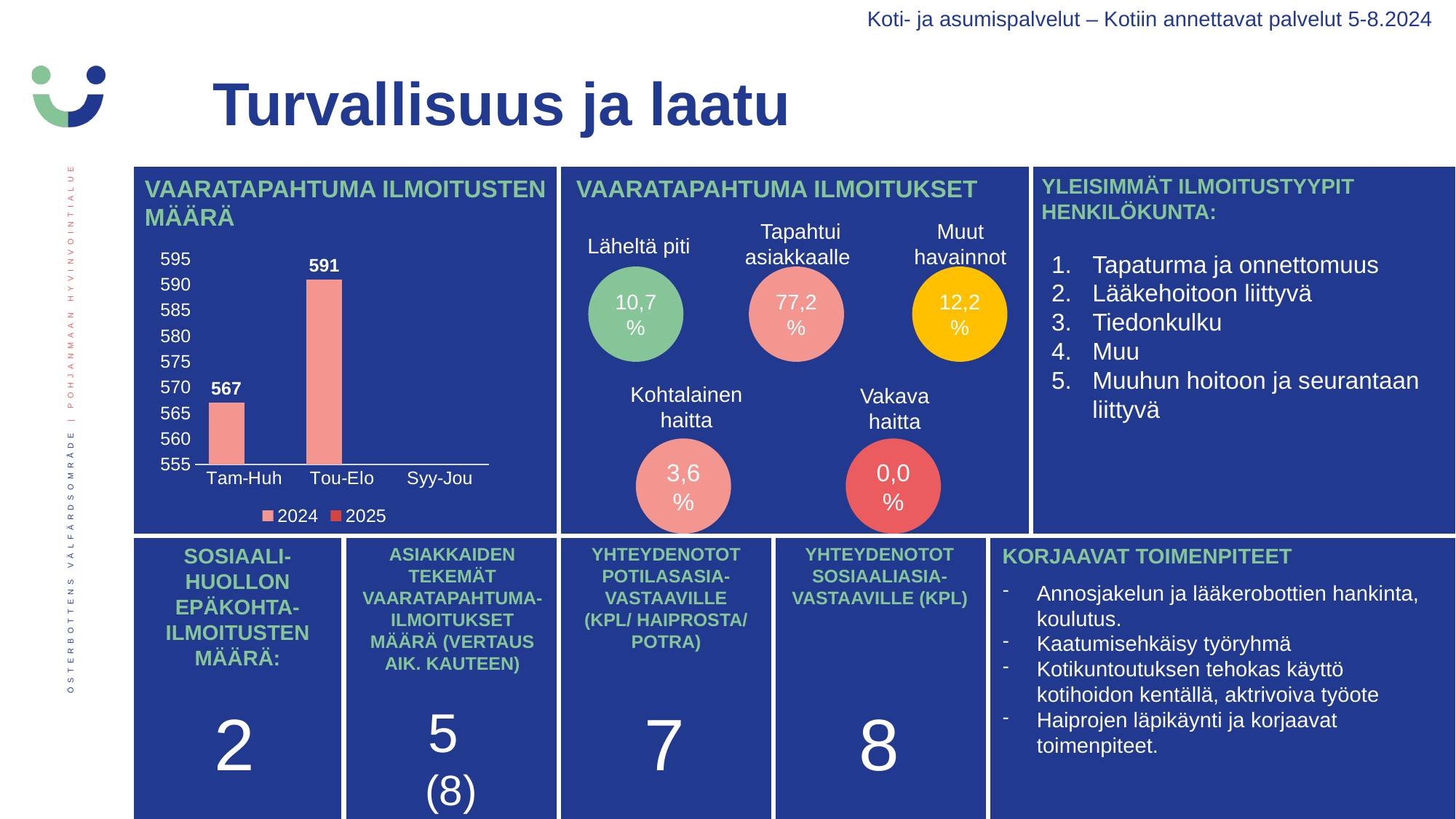
How many series does the legend of the bar chart 'VAARATAPAHTUMA ILMOITUSTEN MÄÄRÄ' list? 2 In the bar chart 'VAARATAPAHTUMA ILMOITUSTEN MÄÄRÄ', which of the plotted bars has the lowest value? Tam-Huh In the bar chart 'VAARATAPAHTUMA ILMOITUSTEN MÄÄRÄ', which category has the highest value? Tou-Elo How many categories are shown on the x axis of the bar chart 'VAARATAPAHTUMA ILMOITUSTEN MÄÄRÄ'? 3 In the bar chart 'VAARATAPAHTUMA ILMOITUSTEN MÄÄRÄ', do the values rise or fall from Tam-Huh to Tou-Elo? rise What are the two legend entries of the bar chart 'VAARATAPAHTUMA ILMOITUSTEN MÄÄRÄ'? 2024 and 2025 In the bar chart 'VAARATAPAHTUMA ILMOITUSTEN MÄÄRÄ', is the value for Tam-Huh greater or less than 570? less In the bar chart 'VAARATAPAHTUMA ILMOITUSTEN MÄÄRÄ', what is the value for Tou-Elo? 591 What kind of chart is 'VAARATAPAHTUMA ILMOITUSTEN MÄÄRÄ'? bar chart In the bar chart 'VAARATAPAHTUMA ILMOITUSTEN MÄÄRÄ', what is the value for Tam-Huh? 567 In the bar chart 'VAARATAPAHTUMA ILMOITUSTEN MÄÄRÄ', what is the difference between the Tou-Elo and Tam-Huh values? 24 In the bar chart 'VAARATAPAHTUMA ILMOITUSTEN MÄÄRÄ', which is larger, Tam-Huh or Tou-Elo? Tou-Elo